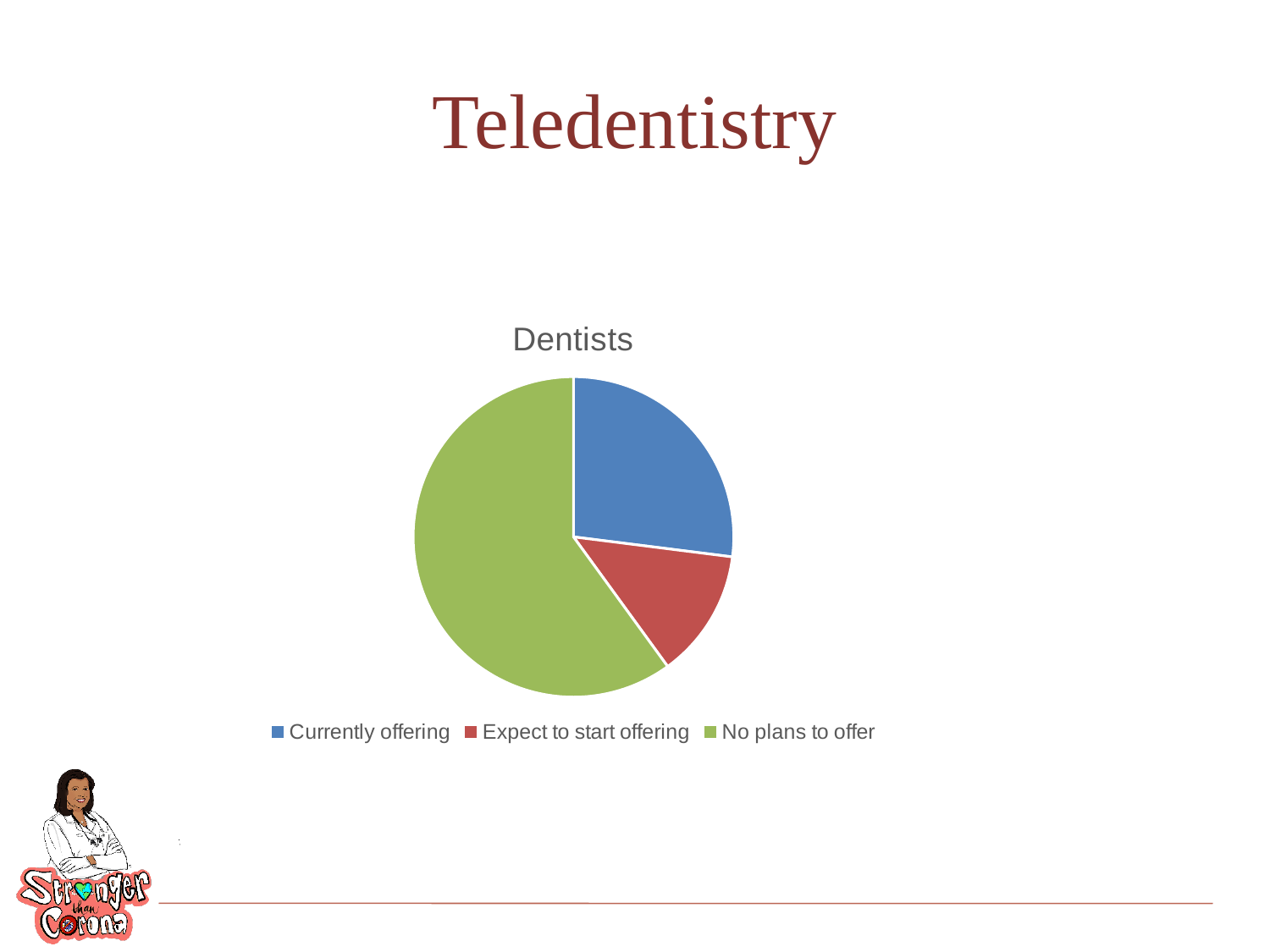
What is the title of the pie chart? Dentists Which category has the smallest slice of the pie? Expect to start offering Which category has the largest slice of the pie? No plans to offer How many slices does the pie chart have? 3 Which slice is larger: No plans to offer or Currently offering? No plans to offer Which colour represents the No plans to offer slice? green What kind of chart is shown on the slide? pie chart Does the No plans to offer slice make up more or less than half of the pie? more How many entries does the legend list? 3 Which slice is larger: Currently offering or Expect to start offering? Currently offering